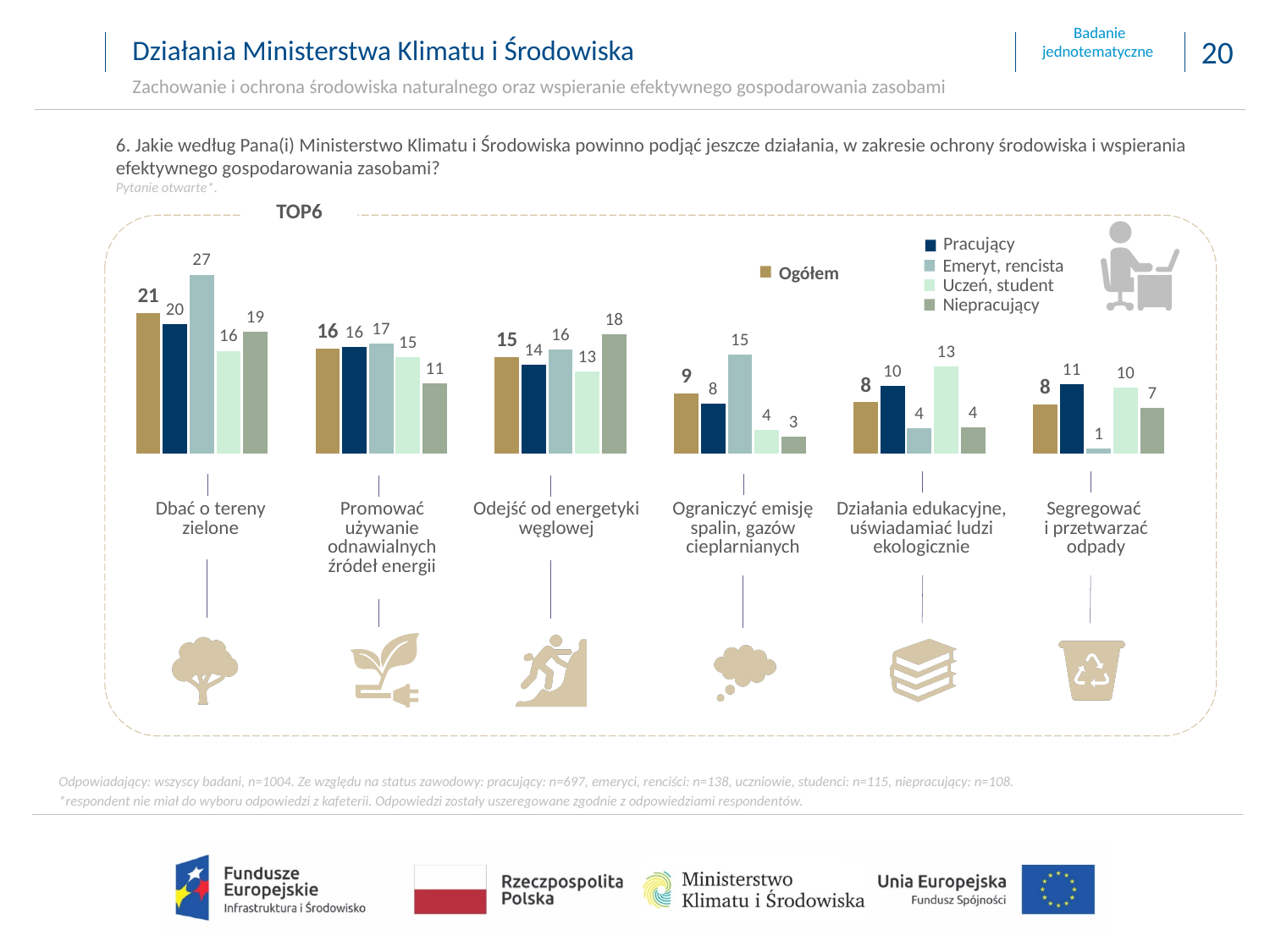
Which category has the highest Ogółem value? Dbać o tereny zielone What is the value for Emeryt, rencista in the "Segregować i przetwarzać odpady" category? 1 In the "Odejść od energetyki węglowej" category, which is larger: the Niepracujący value or the Pracujący value? Niepracujący How many categories (actions) are shown in the TOP6 chart? 6 What is the Ogółem value for "Dbać o tereny zielone"? 21 What is the difference between the Emeryt, rencista value and the Uczeń, student value for "Dbać o tereny zielone"? 11 Which group has the lowest value in the "Ograniczyć emisję spalin, gazów cieplarnianych" category? Niepracujący What is the value for Uczeń, student in the "Działania edukacyjne, uświadamiać ludzi ekologicznie" category? 13 What is the value for Emeryt, rencista in the "Dbać o tereny zielone" category? 27 What kind of chart is shown on the slide? Bar chart How many bars are plotted for each category? 5 What is the label shown above the chart in bold? TOP6